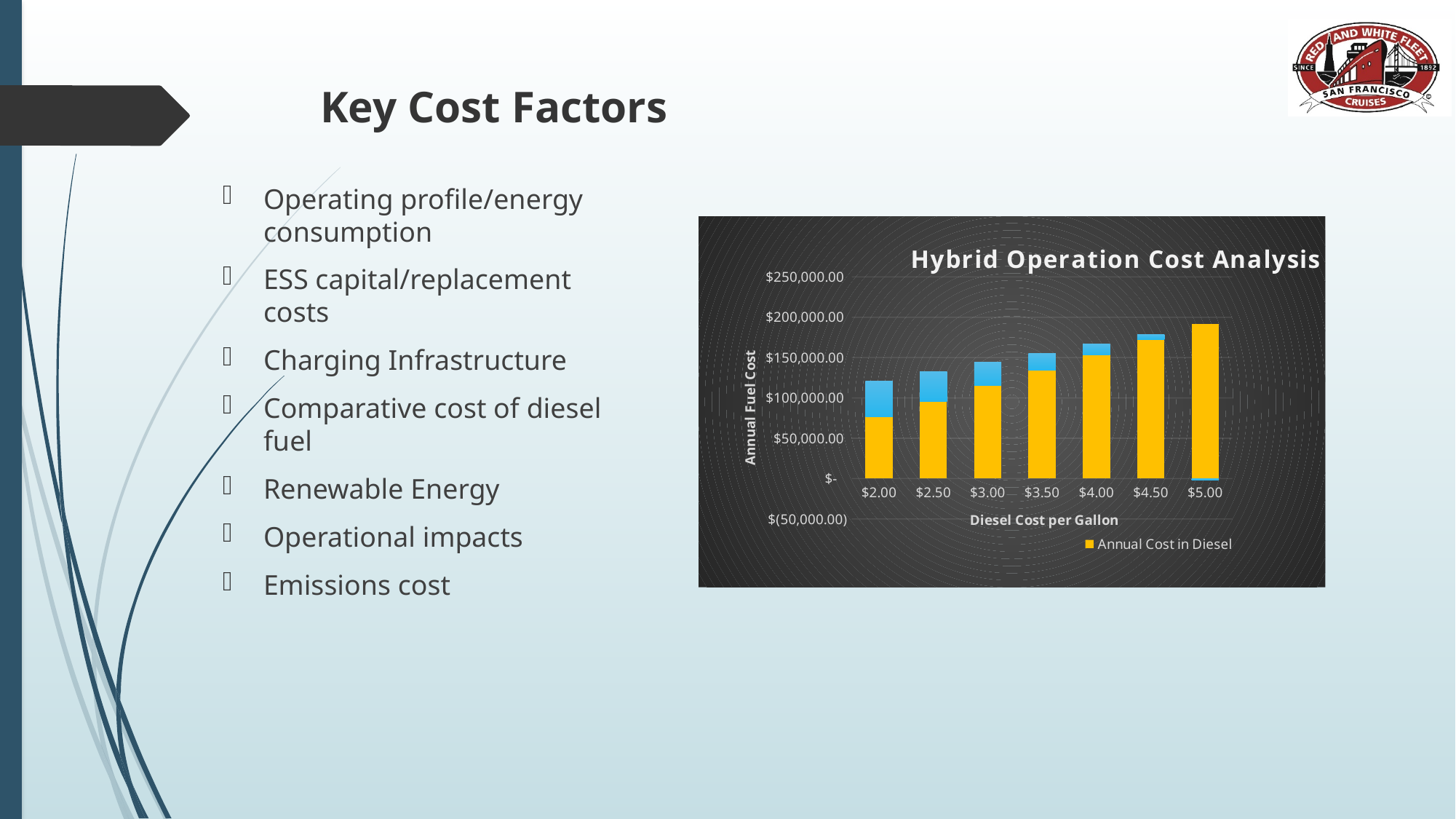
Which diesel cost per gallon has the lowest Annual Cost in Diesel? $2.00 What kind of chart is shown on the slide? bar chart What series name appears in the chart legend? Annual Cost in Diesel Does the Annual Cost in Diesel rise or fall as the diesel cost per gallon increases? rise How many diesel cost per gallon categories are shown on the x axis? 7 Which diesel cost per gallon has the highest Annual Cost in Diesel? $5.00 Is the Annual Cost in Diesel at $3.50 per gallon greater or less than $150,000.00? less Is the Annual Cost in Diesel at $5.00 per gallon greater or less than $150,000.00? greater Which is larger, the Annual Cost in Diesel at $3.00 per gallon or at $4.50 per gallon? $4.50 How many series does the chart legend list? 1 What is the title of the chart? Hybrid Operation Cost Analysis Is the Annual Cost in Diesel at $2.00 per gallon greater or less than $100,000.00? less